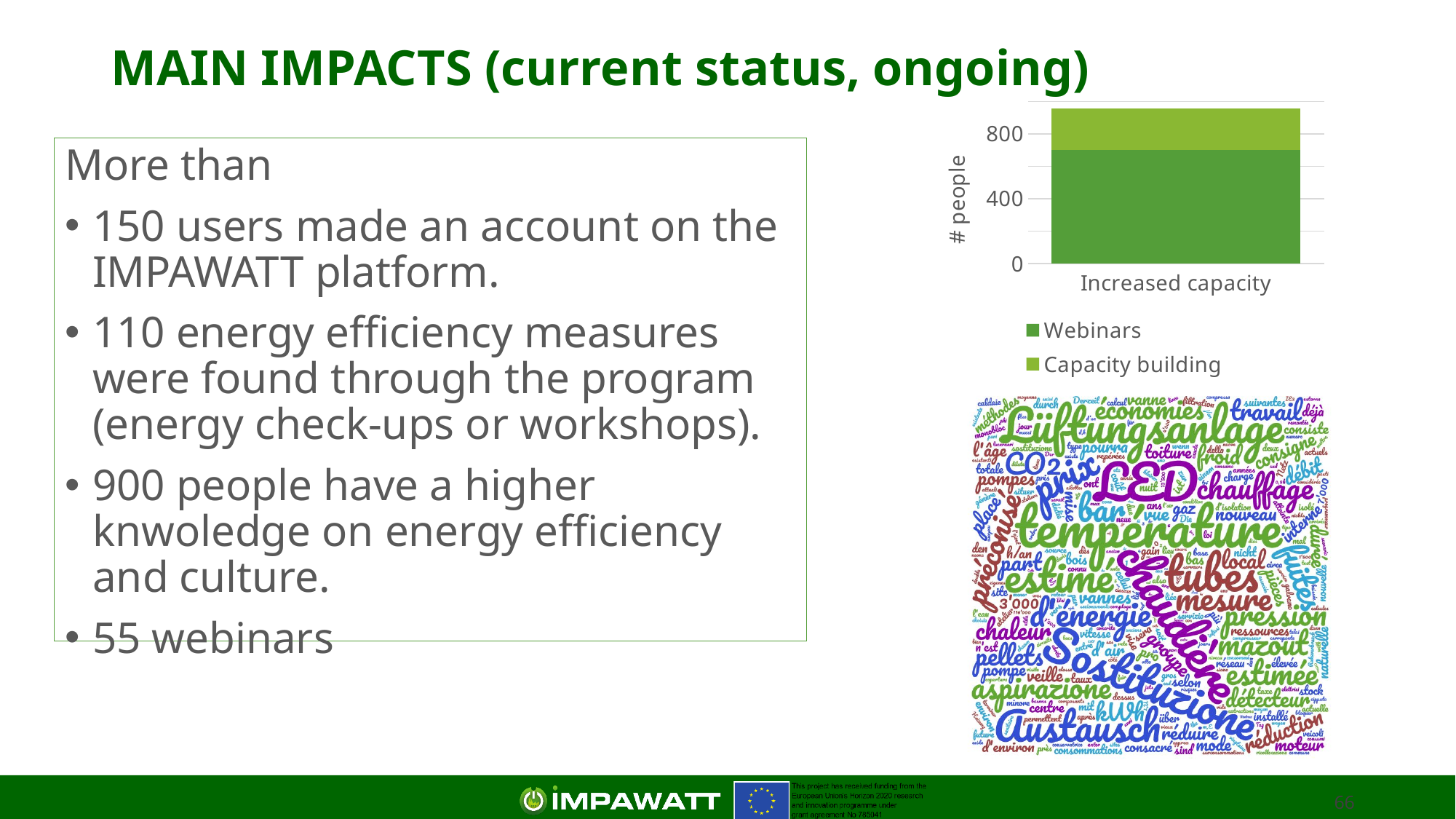
Which series is drawn at the bottom of the stacked bar? Webinars Which series contributes more to the Increased capacity bar, Webinars or Capacity building? Webinars Is the Capacity building segment of the bar greater or less than 400 people? less Is the value of the Webinars segment in the chart greater or less than 400? greater How many categories are shown on the x axis of the chart? 1 What is the category label on the x axis of the chart? Increased capacity What is the label of the vertical axis of the chart? # people Is the total height of the stacked bar for Increased capacity greater or less than 800? greater How many series does the chart legend list? 2 What kind of chart is shown on the slide? Stacked bar chart